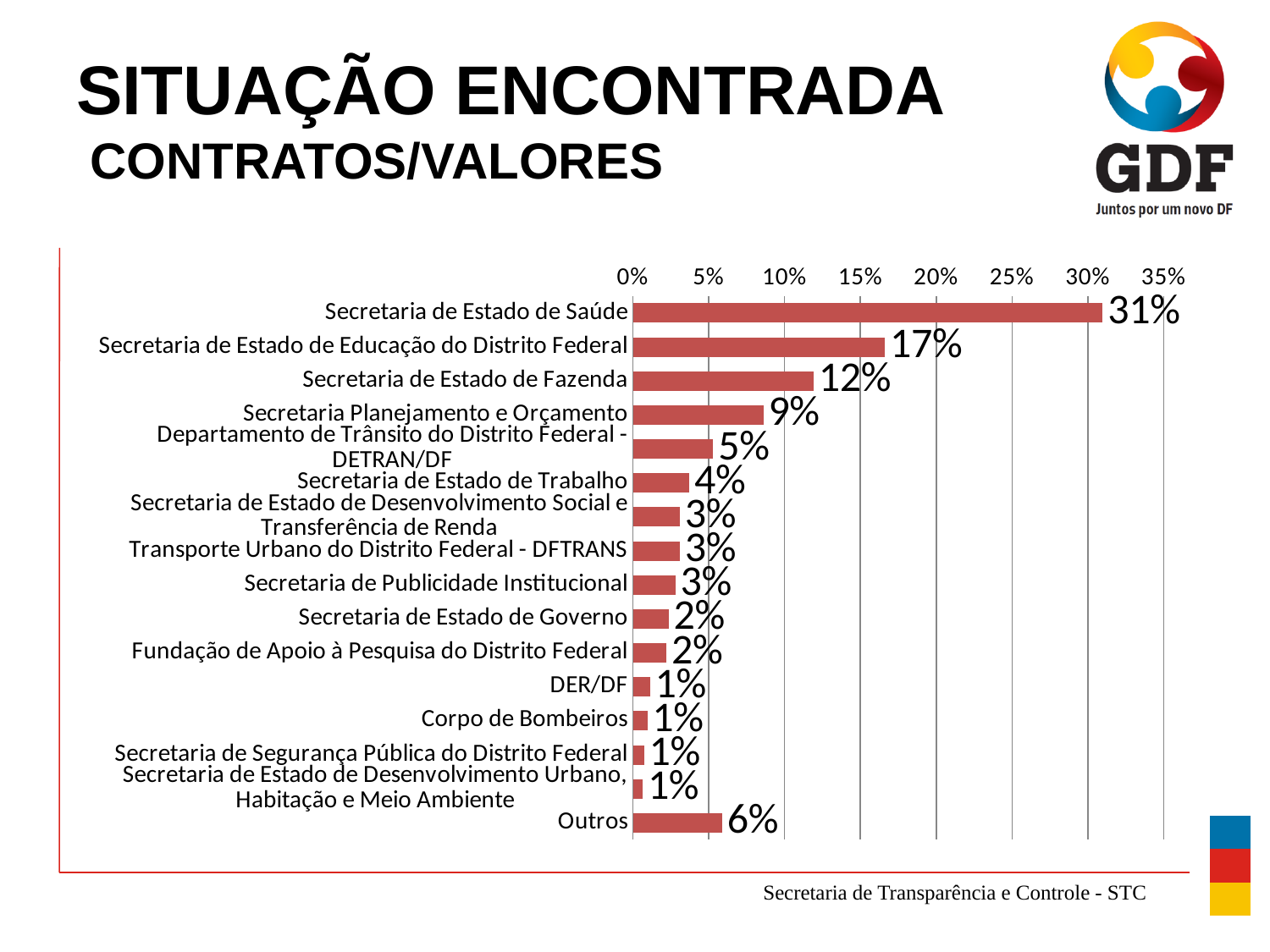
What is the value for Secretaria de Estado de Educação do Distrito Federal? 17% What kind of chart is shown on the slide? bar chart What is the value for Departamento de Trânsito do Distrito Federal - DETRAN/DF? 5% Which category has the highest value? Secretaria de Estado de Saúde What is the value for Secretaria de Estado de Saúde? 31% What is the value for Secretaria de Estado de Trabalho? 4% What is the value for Outros? 6% Is the value for Secretaria de Estado de Saúde greater or less than 30%? greater How many categories are shown in the chart? 16 What is the value for Secretaria de Estado de Fazenda? 12% Which is larger, the value for Secretaria Planejamento e Orçamento or the value for Outros? Secretaria Planejamento e Orçamento What is the difference between the values for Secretaria de Estado de Saúde and Secretaria de Estado de Educação do Distrito Federal? 14%